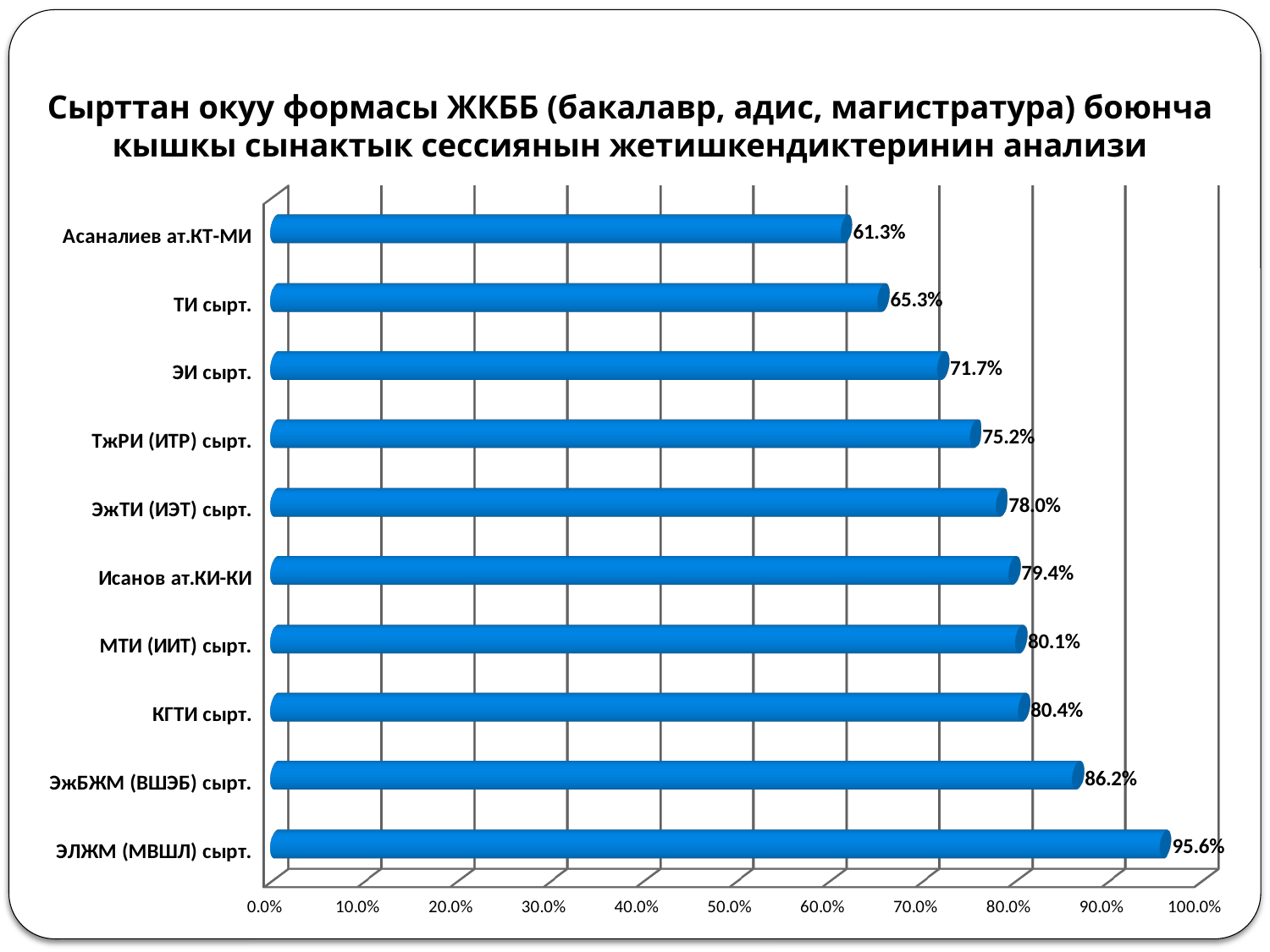
How many categories are shown in the chart? 10 What is the difference between the values for ЭжБЖМ (ВШЭБ) сырт. and КГТИ сырт.? 5.8 percentage points What is the value for ТИ сырт.? 65.3% What is the value for ЭЛЖМ (МВШЛ) сырт.? 95.6% Which is larger, the value for ЭжБЖМ (ВШЭБ) сырт. or the value for ТжРИ (ИТР) сырт.? ЭжБЖМ (ВШЭБ) сырт. What is the difference between the values for ЭЛЖМ (МВШЛ) сырт. and Асаналиев ат.КТ-МИ? 34.3 percentage points Which category has the highest value? ЭЛЖМ (МВШЛ) сырт. Is the value for ЭИ сырт. greater or less than 70.0%? greater What is the value for Исанов ат.КИ-КИ? 79.4% What is the value for ЭжТИ (ИЭТ) сырт.? 78.0% What kind of chart is shown on the slide? Bar chart Which category has the lowest value? Асаналиев ат.КТ-МИ